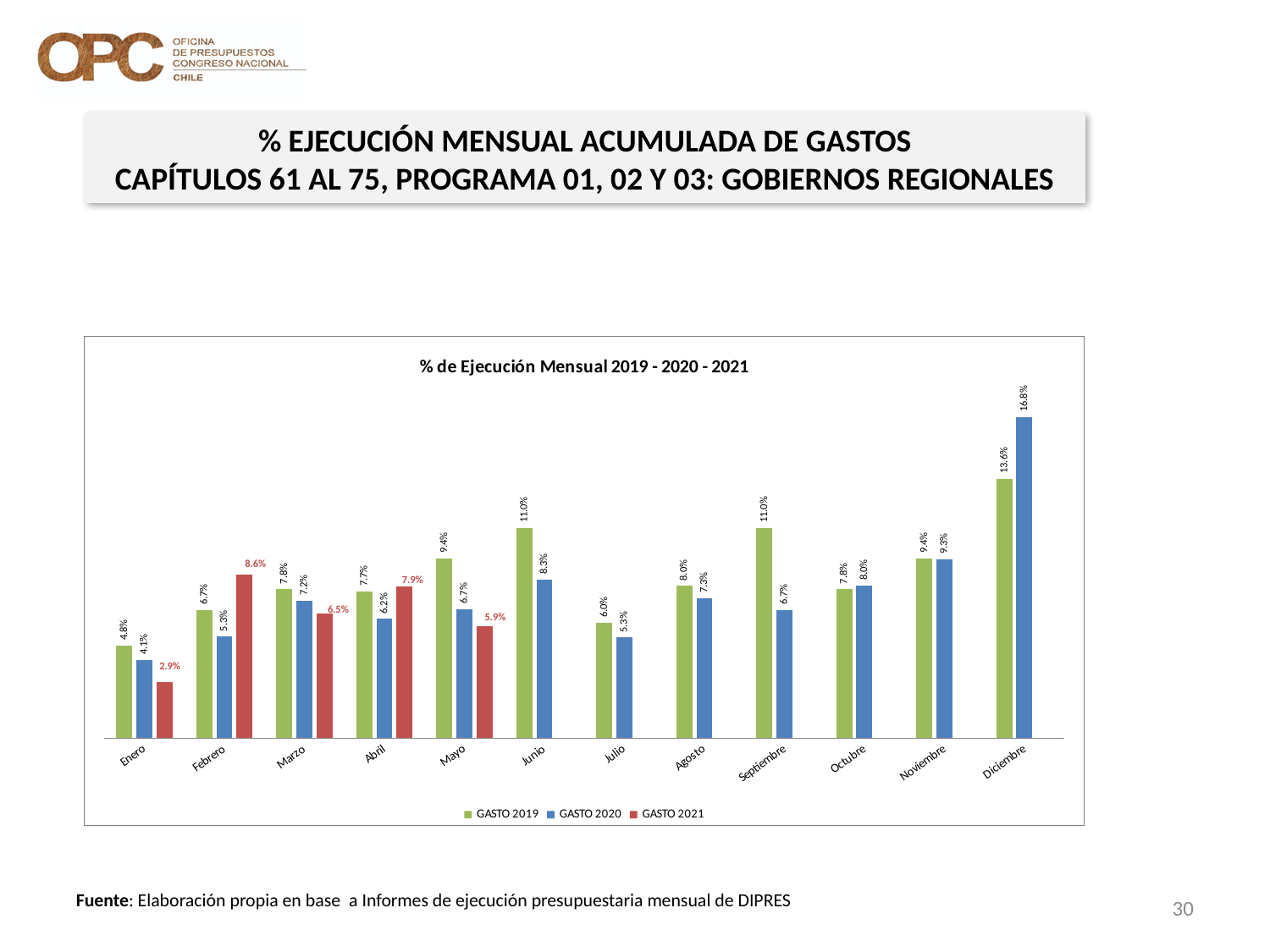
What is the difference between GASTO 2020 and GASTO 2019 in Diciembre? 3.2% What is the value for GASTO 2021 in Febrero? 8.6% What is the value for GASTO 2019 in Septiembre? 11.0% How many months are shown on the x axis? 12 What is the title of the chart? % de Ejecución Mensual 2019 - 2020 - 2021 Which month has the highest value for GASTO 2020? Diciembre How many series does the legend list? 3 What is the value for GASTO 2021 in Enero? 2.9% Which is larger in Abril, GASTO 2019 or GASTO 2021? GASTO 2021 Which month has the lowest value for GASTO 2019? Enero What kind of chart is shown on the slide? Bar chart What is the value for GASTO 2020 in Diciembre? 16.8%